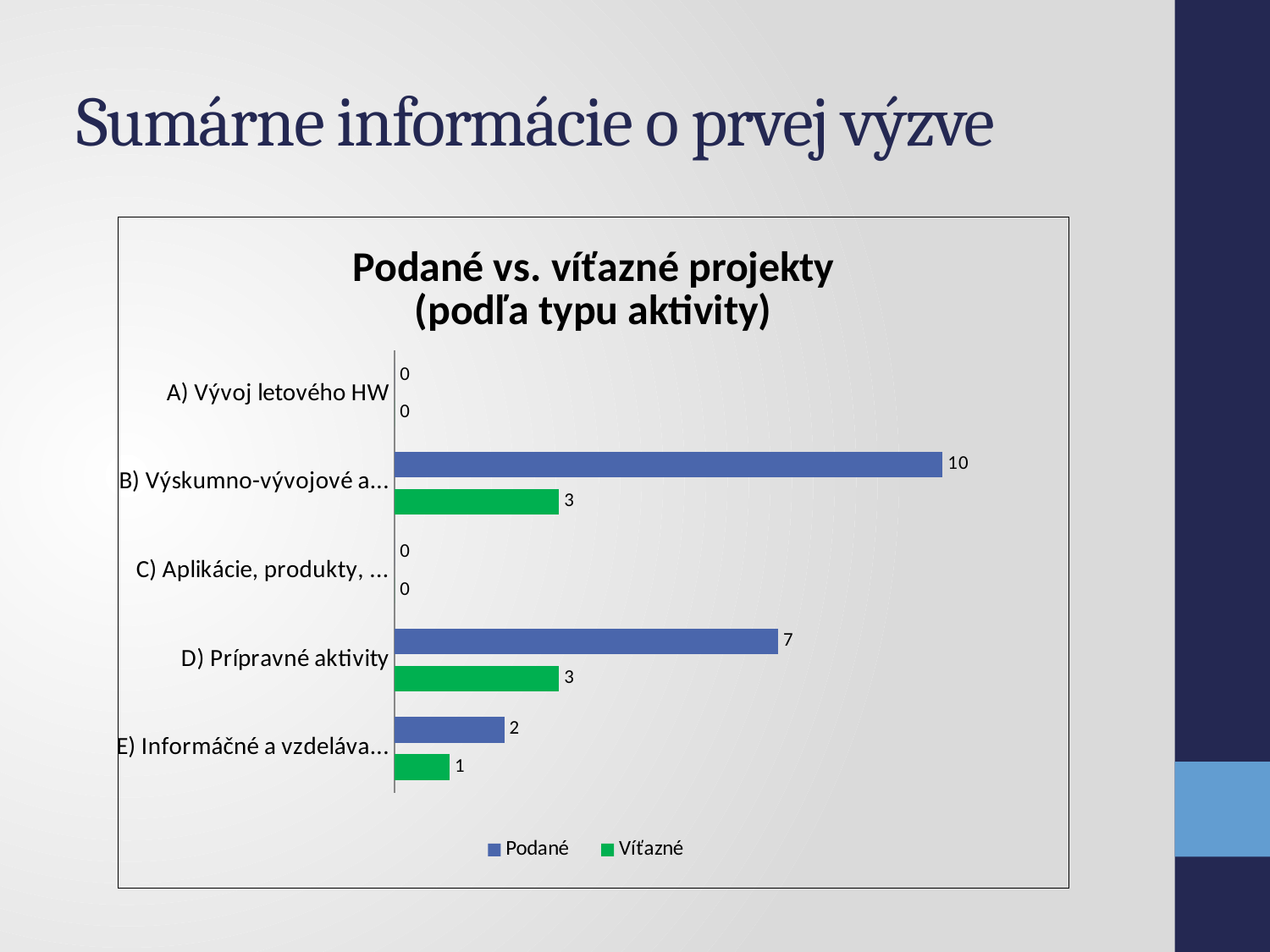
What is the Víťazné value for B) Výskumno-vývojové a…? 3 What is the difference between the Podané values for D) Prípravné aktivity and E) Informáčné a vzdeláva…? 5 Which category has the highest Podané value? B) Výskumno-vývojové a… How many series does the legend list? 2 Which is larger, the Víťazné value for D) Prípravné aktivity or the Víťazné value for E) Informáčné a vzdeláva…? D) Prípravné aktivity What is the Podané value for E) Informáčné a vzdeláva…? 2 What is the difference between the Podané and Víťazné values for B) Výskumno-vývojové a…? 7 What kind of chart is shown on the slide? Bar chart What is the Víťazné value for A) Vývoj letového HW? 0 What is the Podané value for D) Prípravné aktivity? 7 How many categories are shown on the chart? 5 What is the title of the chart? Podané vs. víťazné projekty (podľa typu aktivity)